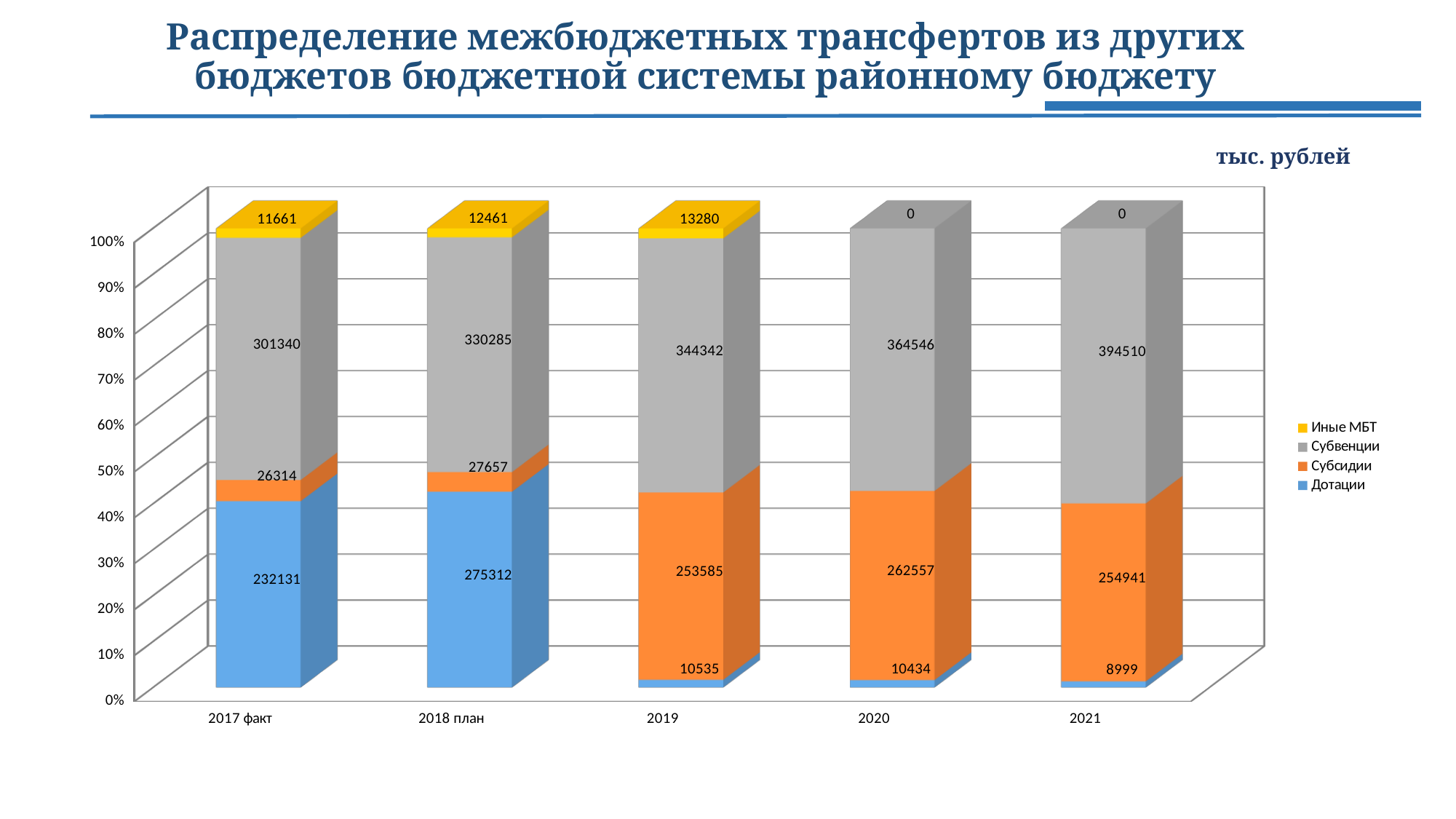
In which category is the Субвенции value highest? 2021 What is the difference between the Субвенции values for 2021 and 2017 факт? 93170 What is the value of Иные МБТ for 2020? 0 How many series does the legend list? 4 What is the total of the stacked bar for 2017 факт? 571446 What is the value of Дотации for 2018 план? 275312 What is the value of Субсидии for 2019? 253585 Which is larger: Субсидии for 2020 or Субсидии for 2021? Субсидии for 2020 What kind of chart is shown on the slide? Stacked bar chart What is the value of Субвенции for 2021? 394510 How many categories are shown on the x axis? 5 In which category is the Дотации value lowest? 2021